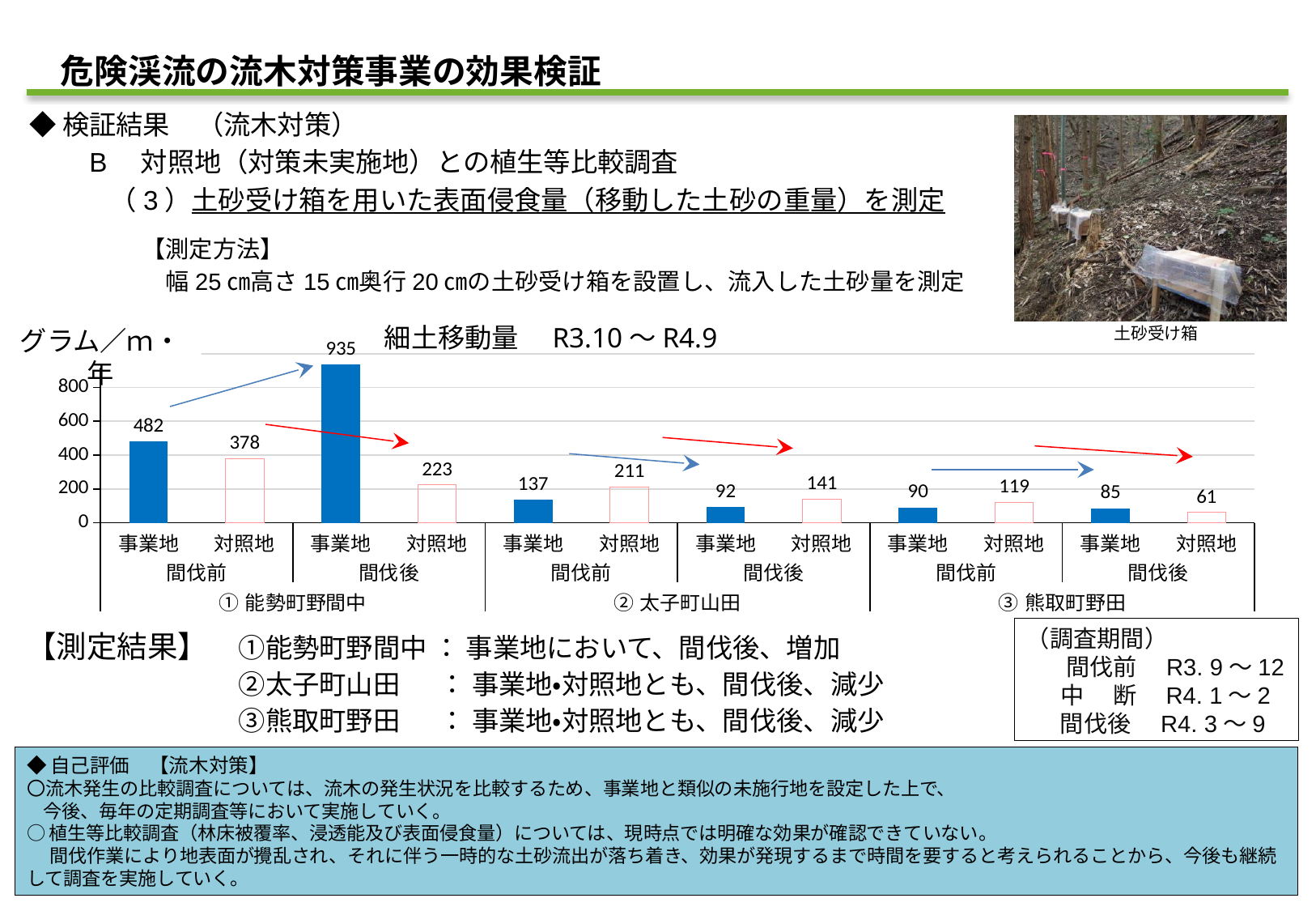
How many bars are plotted in the chart? 12 What is the value for 事業地 after thinning (間伐後) at ① 能勢町野間中? 935 What is the value for 対照地 before thinning (間伐前) at ① 能勢町野間中? 378 What is the difference between the 事業地 values before and after thinning at ① 能勢町野間中? 453 At ② 太子町山田 before thinning (間伐前), which is larger, 事業地 or 対照地? 対照地 What is the value for 事業地 before thinning (間伐前) at ② 太子町山田? 137 Which bar has the highest value in the chart? 事業地, 間伐後, ① 能勢町野間中 (935) What is the value for 対照地 after thinning (間伐後) at ③ 熊取町野田? 61 What is the title of the chart? 細土移動量 R3.10 〜 R4.9 What type of chart is shown on the slide? bar chart What is the unit shown on the vertical axis of the chart? グラム／m・年 Which bar has the lowest value in the chart? 対照地, 間伐後, ③ 熊取町野田 (61)